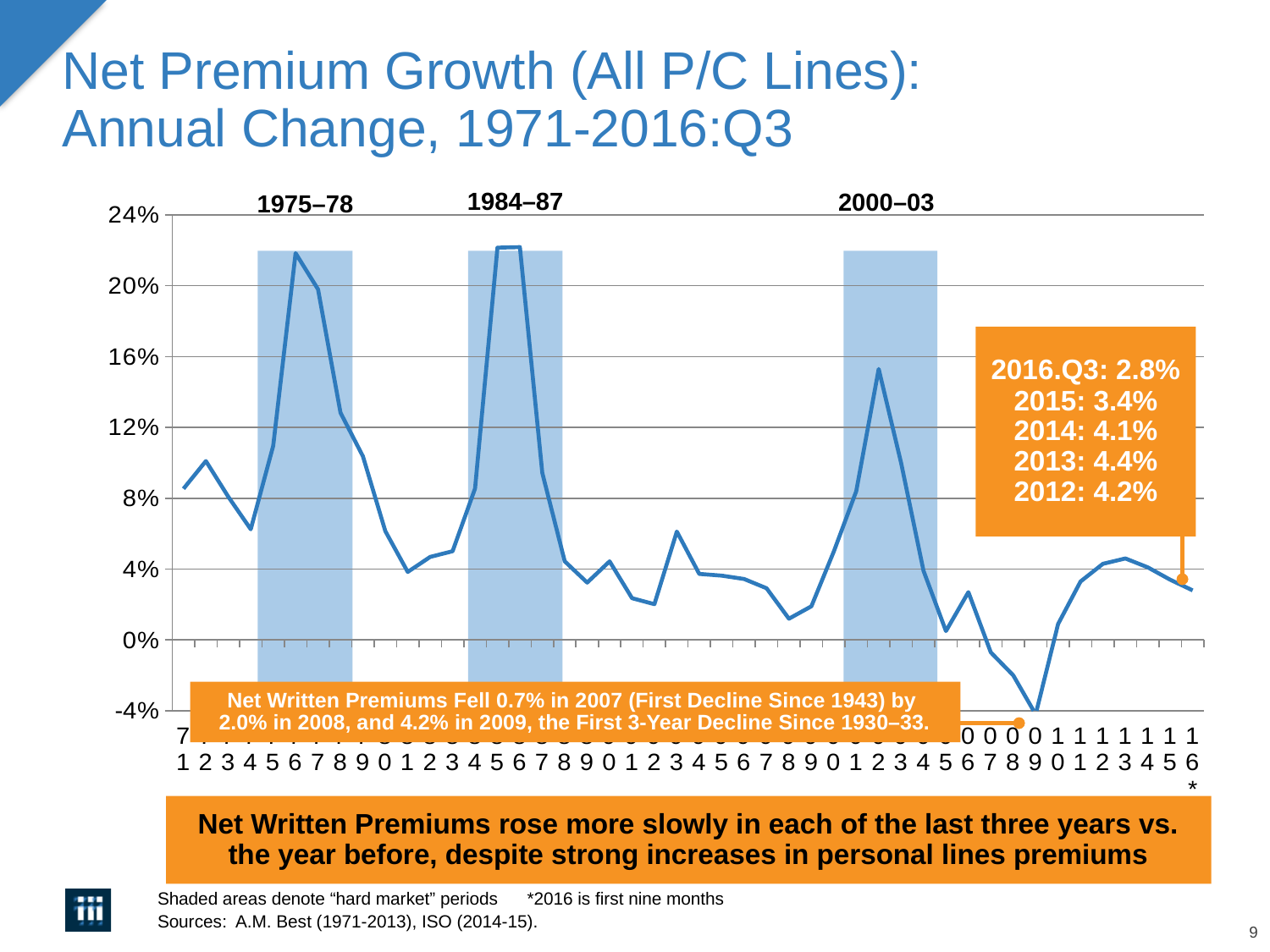
Which year had higher net premium growth, 2014 or 2015? 2014 How many shaded 'hard market' periods are marked on the chart? 3 What was the net premium growth in 2012? 4.2% By how much did net written premiums fall in 2009, according to the text box on the chart? 4.2% Is the peak value of the line during the 1984–87 shaded period greater or less than 20%? greater What net premium growth value is shown for 2016.Q3? 2.8% What type of chart is used to show net premium growth on this slide? line chart Did net premium growth rise or fall from 2013 to 2016.Q3? fall What was the net premium growth for 2015 according to the callout on the chart? 3.4% What was the net premium growth in 2013? 4.4% What is the difference between the net premium growth in 2013 (4.4%) and 2012 (4.2%)? 0.2 percentage points Is the value of the line at 2009 greater or less than 0%? less